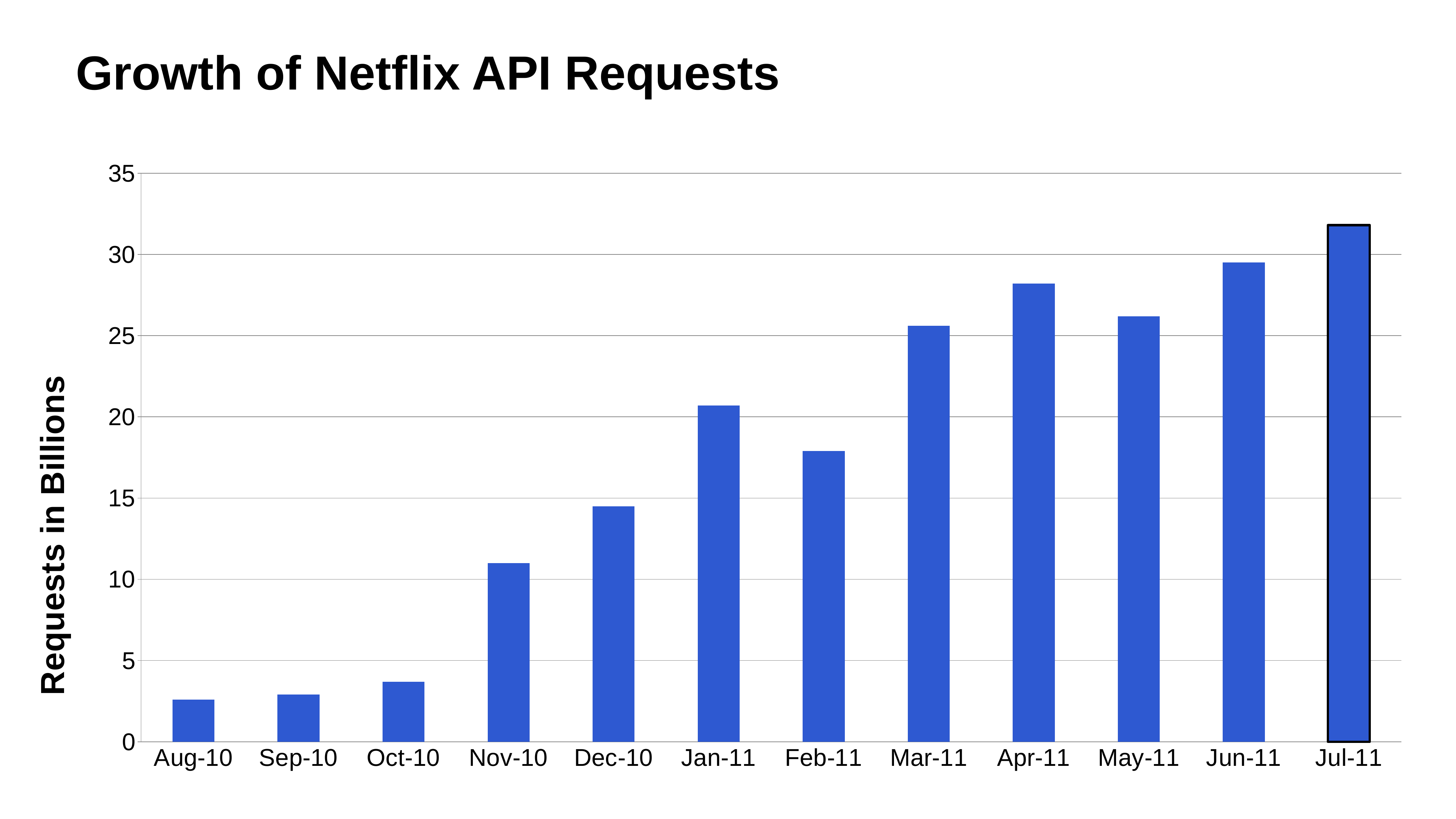
What type of chart is shown on the slide? Bar chart Is the value for Nov-10 greater or less than 10? greater Which month has the highest number of API requests? Jul-11 Is the value for Aug-10 greater or less than 5? less Which is larger, the value for Apr-11 or the value for May-11? Apr-11 Is the value for Dec-10 greater or less than 15? less Do the values generally rise or fall from Aug-10 to Jul-11? Rise Which is larger, the value for Jan-11 or the value for Feb-11? Jan-11 How many months are plotted on the x axis? 12 What is the label on the y axis? Requests in Billions